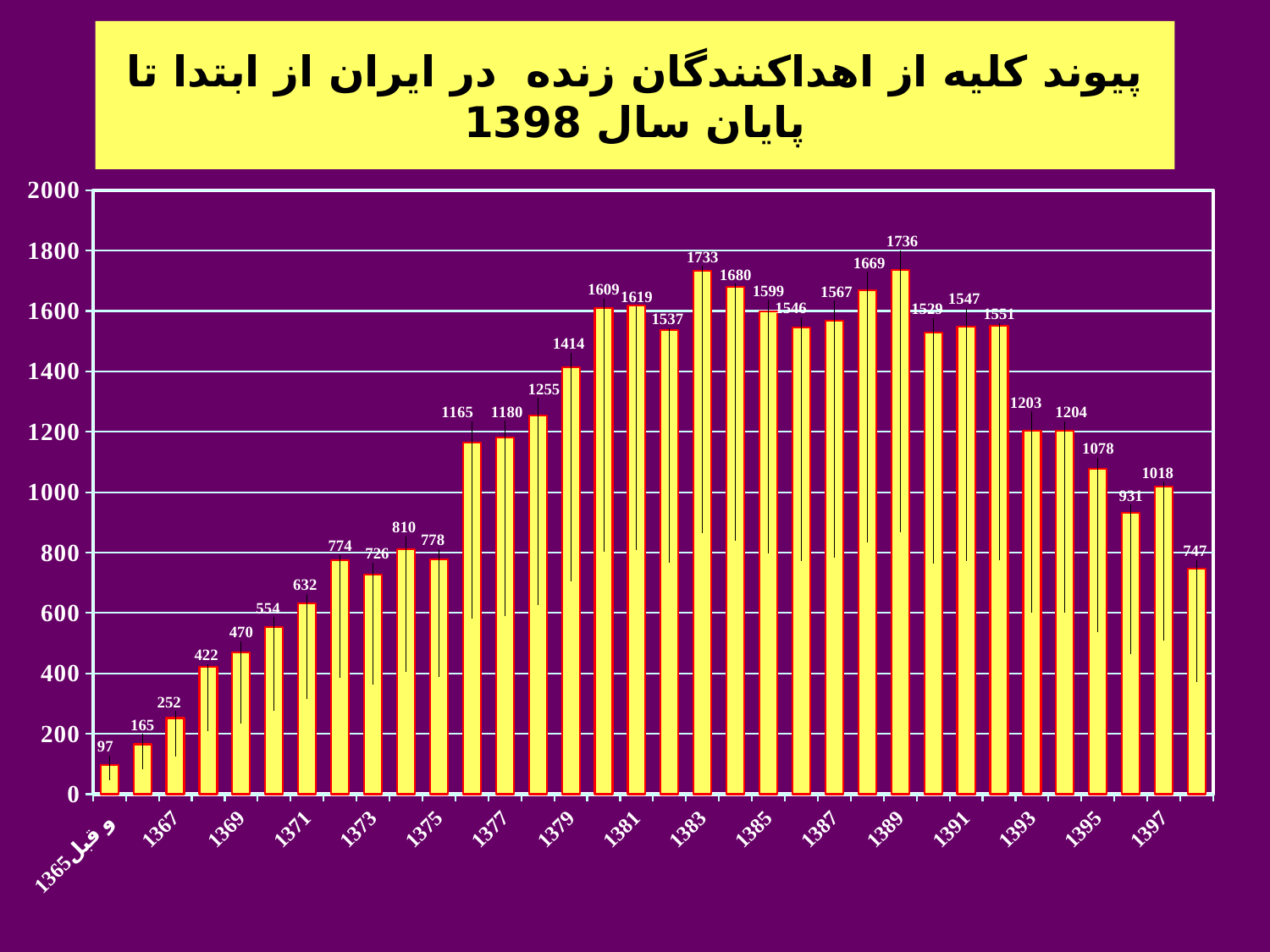
Which is larger, the value for 1381 or the value for 1385? 1381 What kind of chart is shown on the slide? bar chart What is the value for 1383? 1733 How many bars are plotted in the chart? 34 What is the value for 1389? 1736 Is the value for 1379 greater or less than 1200? greater What is the value for 1397? 1018 What is the difference between the values for 1389 and 1397? 718 Which category has the lowest value? 1365 و قبل Which year has the highest value? 1389 What is the value for 1373? 726